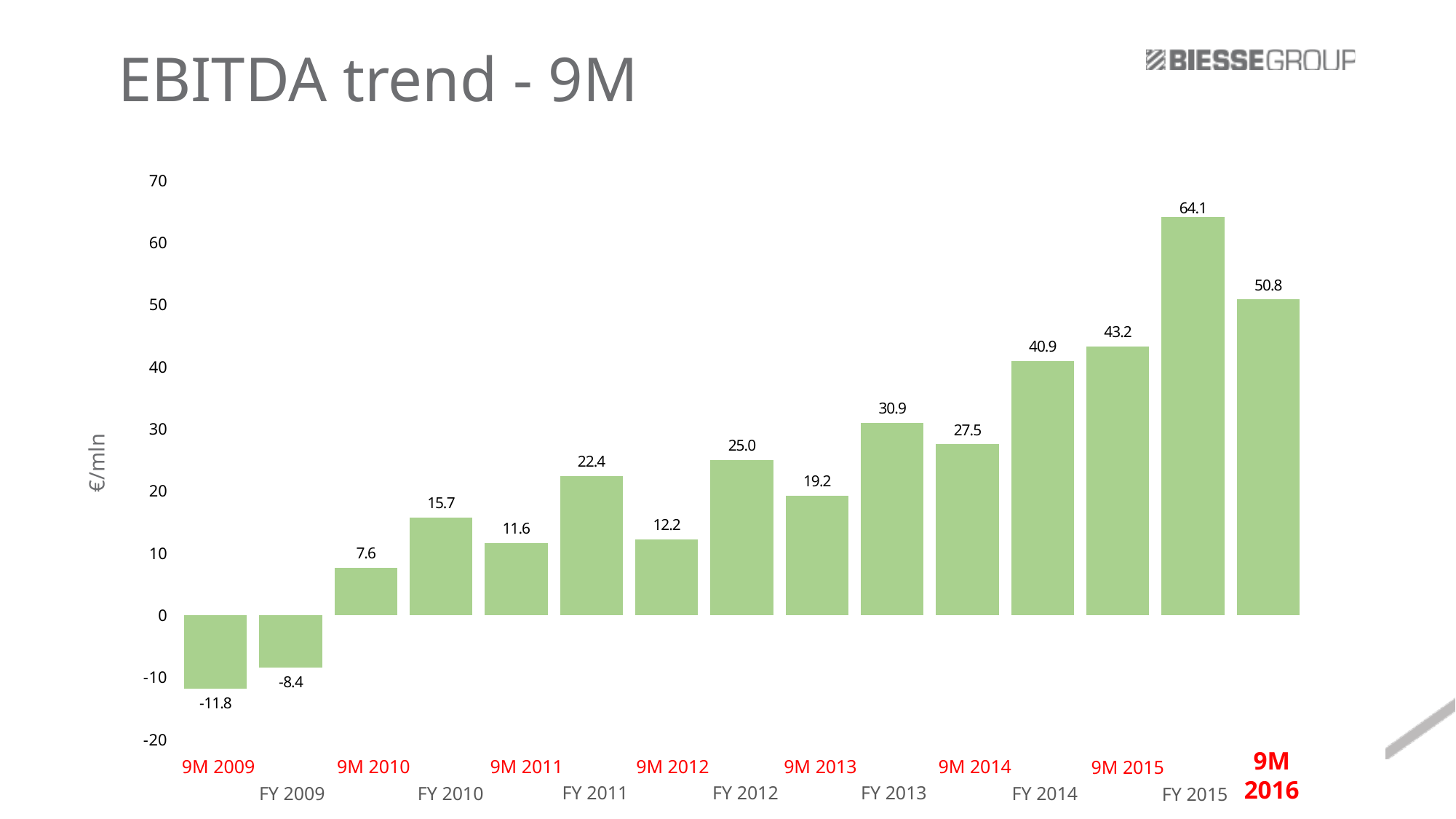
What is the EBITDA value for 9M 2009? -11.8 What unit is shown on the vertical axis of the chart? €/mln What type of chart is shown on the slide? Bar chart Which is larger, the EBITDA for 9M 2013 or 9M 2014? 9M 2014 Do the 9M EBITDA values generally rise or fall from 9M 2009 to 9M 2016? Rise What is the EBITDA value for FY 2012? 25.0 What is the EBITDA value for 9M 2016? 50.8 How many bars are shown in the chart? 15 What is the difference between the EBITDA for 9M 2016 and 9M 2015? 7.6 What is the EBITDA value for FY 2015? 64.1 Which period has the highest EBITDA? FY 2015 Which period has the lowest EBITDA? 9M 2009